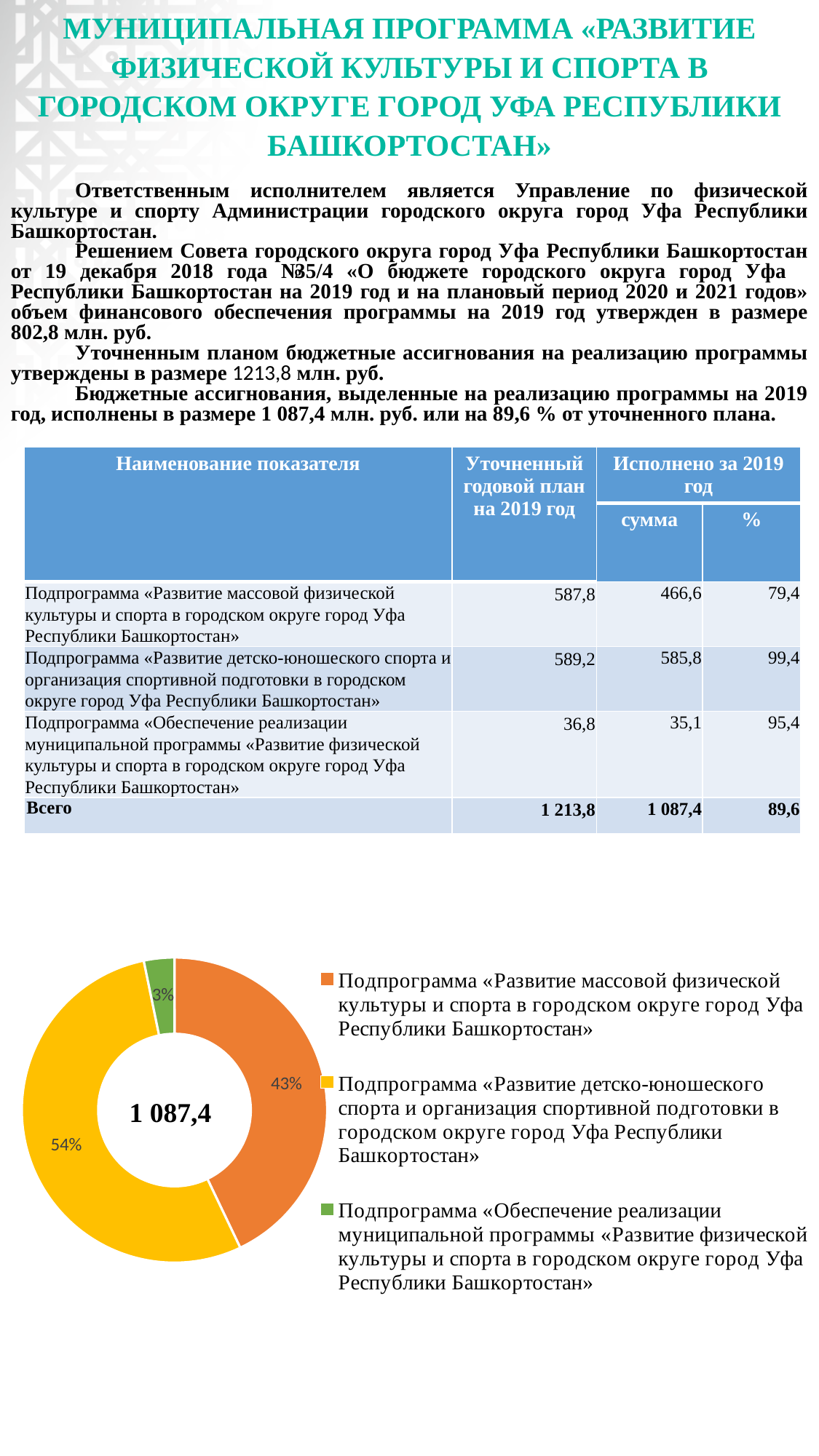
What share of the doughnut chart does the subprogram «Развитие массовой физической культуры и спорта в городском округе город Уфа Республики Башкортостан» take? 43% What number is printed in the centre of the doughnut chart? 1 087,4 In the doughnut chart, what is the difference in percentage points between the 54% slice and the 43% slice? 11 percentage points What share of the doughnut chart does the subprogram «Обеспечение реализации муниципальной программы «Развитие физической культуры и спорта в городском округе город Уфа Республики Башкортостан» take? 3% Which subprogram has the smallest slice in the doughnut chart? Подпрограмма «Обеспечение реализации муниципальной программы «Развитие физической культуры и спорта в городском округе город Уфа Республики Башкортостан» What share of the doughnut chart does the subprogram «Развитие детско-юношеского спорта и организация спортивной подготовки в городском округе город Уфа Республики Башкортостан» take? 54% How many entries does the legend of the doughnut chart list? 3 In the doughnut chart, which slice is larger: the one for «Развитие массовой физической культуры и спорта...» or the one for «Развитие детско-юношеского спорта...»? «Развитие детско-юношеского спорта...» (54%) What kind of chart is shown at the bottom of the slide? Doughnut (pie) chart Which subprogram has the largest slice in the doughnut chart? Подпрограмма «Развитие детско-юношеского спорта и организация спортивной подготовки в городском округе город Уфа Республики Башкортостан» What colour is the slice for the subprogram «Обеспечение реализации муниципальной программы...» in the doughnut chart? Green How many slices does the doughnut chart have? 3